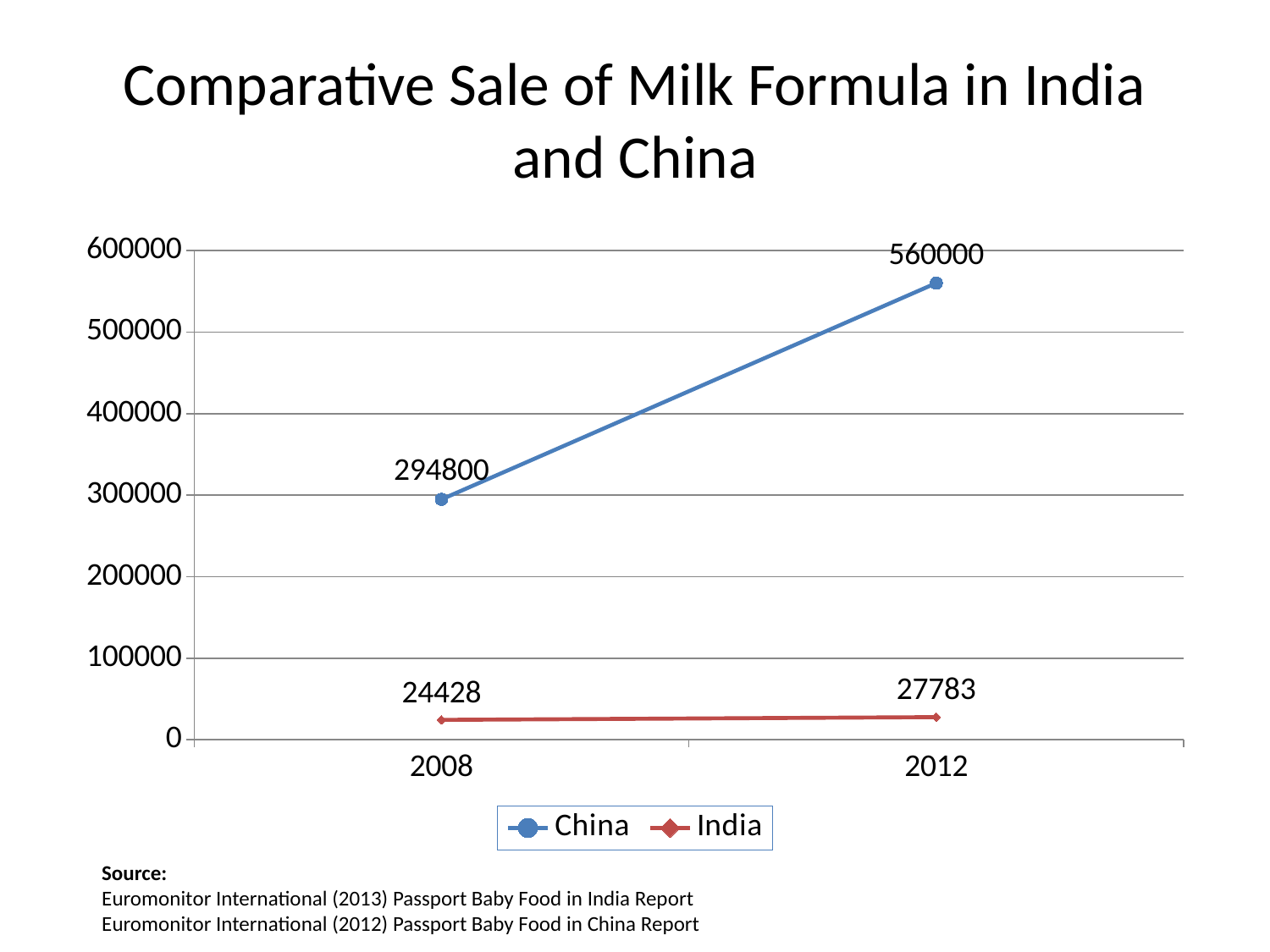
By how much did the value for China increase from 2008 to 2012? 265200 What kind of chart is shown on the slide? Line chart Which series has the higher value in 2008, China or India? China What is the difference between the China and India values in 2012? 532217 Is the value for China in 2012 greater or less than 500000? greater What is the value for India in 2012? 27783 How many series does the legend list? 2 Does the value for India rise or fall from 2008 to 2012? Rise What is the value for India in 2008? 24428 What is the value for China in 2008? 294800 What is the value for China in 2012? 560000 What is the title of the chart? Comparative Sale of Milk Formula in India and China